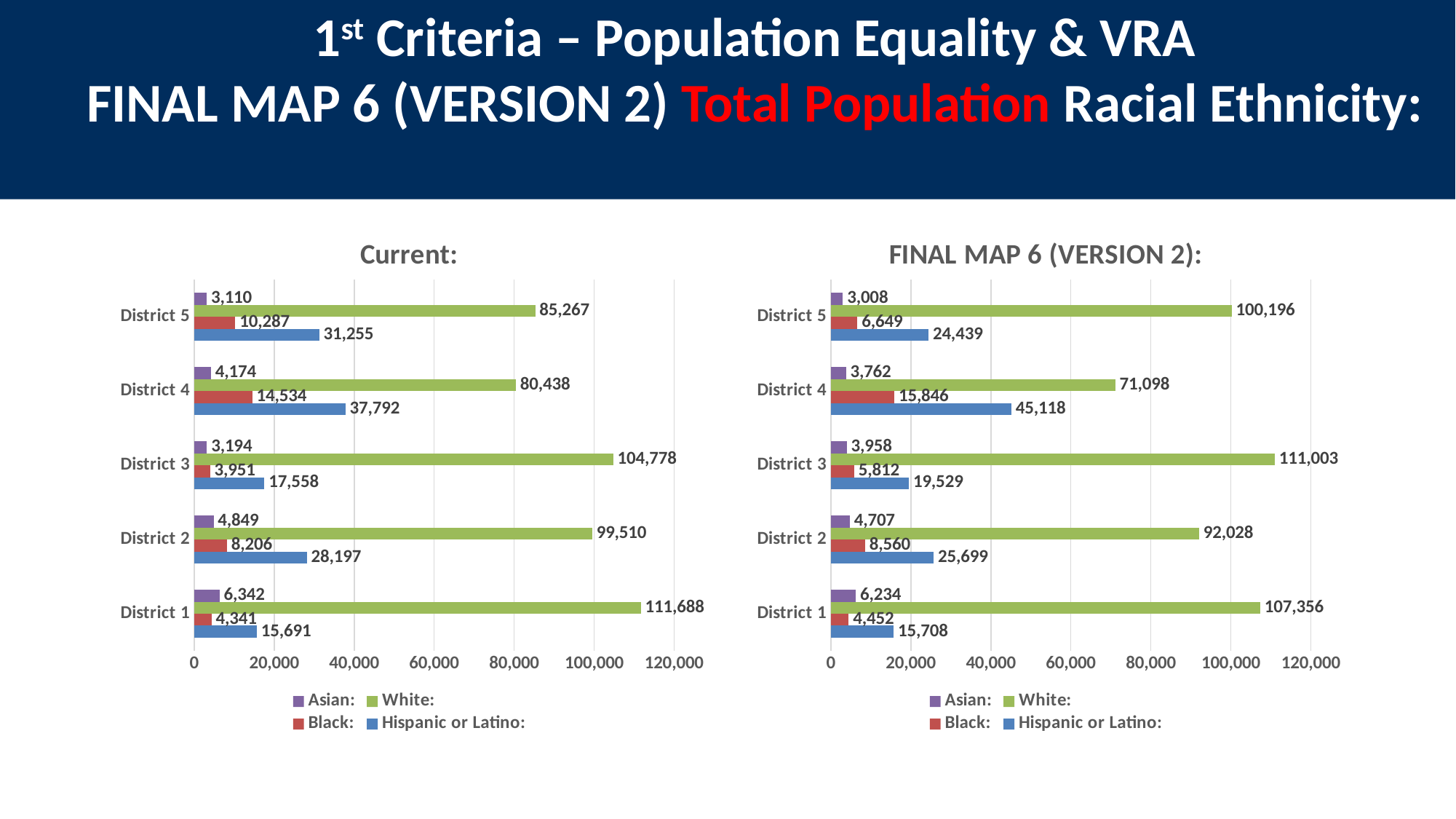
In the "FINAL MAP 6 (VERSION 2):" chart, what is the Black population for District 5? 6,649 What type of chart is the "Current:" chart? Bar chart In the "Current:" chart, is the White population for District 5 greater or less than 80,000? greater In the "FINAL MAP 6 (VERSION 2):" chart, what is the Hispanic or Latino population for District 4? 45,118 In the "Current:" chart, what is the difference between the Hispanic or Latino populations of District 4 and District 1? 22,101 In the "FINAL MAP 6 (VERSION 2):" chart, which is larger: the White population of District 2 or District 4? District 2 In the "FINAL MAP 6 (VERSION 2):" chart, which district has the lowest Hispanic or Latino population? District 1 In the "Current:" chart, what is the White population for District 3? 104,778 How many districts are shown in the "FINAL MAP 6 (VERSION 2):" chart? 5 In the "Current:" chart, which district has the highest White population? District 1 In the "FINAL MAP 6 (VERSION 2):" chart, which colour represents the Asian series? Purple How many series does the legend of the "Current:" chart list? 4